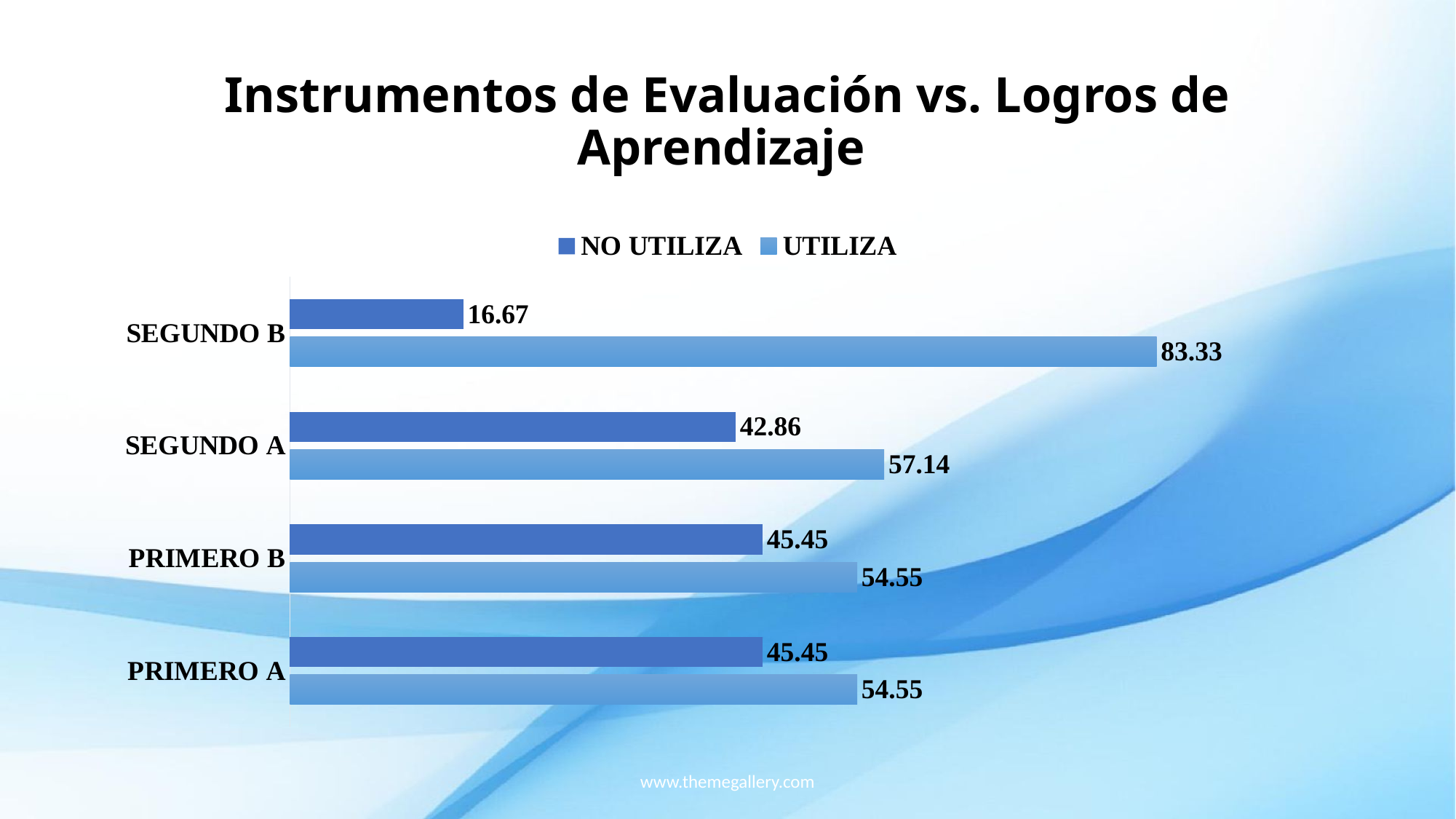
What is the NO UTILIZA value for SEGUNDO A? 42.86 What is the difference between the UTILIZA values for SEGUNDO B and SEGUNDO A? 26.19 What is the UTILIZA value for PRIMERO A? 54.55 What is the UTILIZA value for SEGUNDO B? 83.33 Which category has the highest UTILIZA value? SEGUNDO B What is the NO UTILIZA value for PRIMERO B? 45.45 Which category has the lowest NO UTILIZA value? SEGUNDO B What kind of chart is shown on the slide? Bar chart How many series does the legend list? 2 What is the difference between the UTILIZA and NO UTILIZA values for SEGUNDO B? 66.66 Which is larger for SEGUNDO A: the UTILIZA value or the NO UTILIZA value? UTILIZA How many categories are shown on the chart? 4